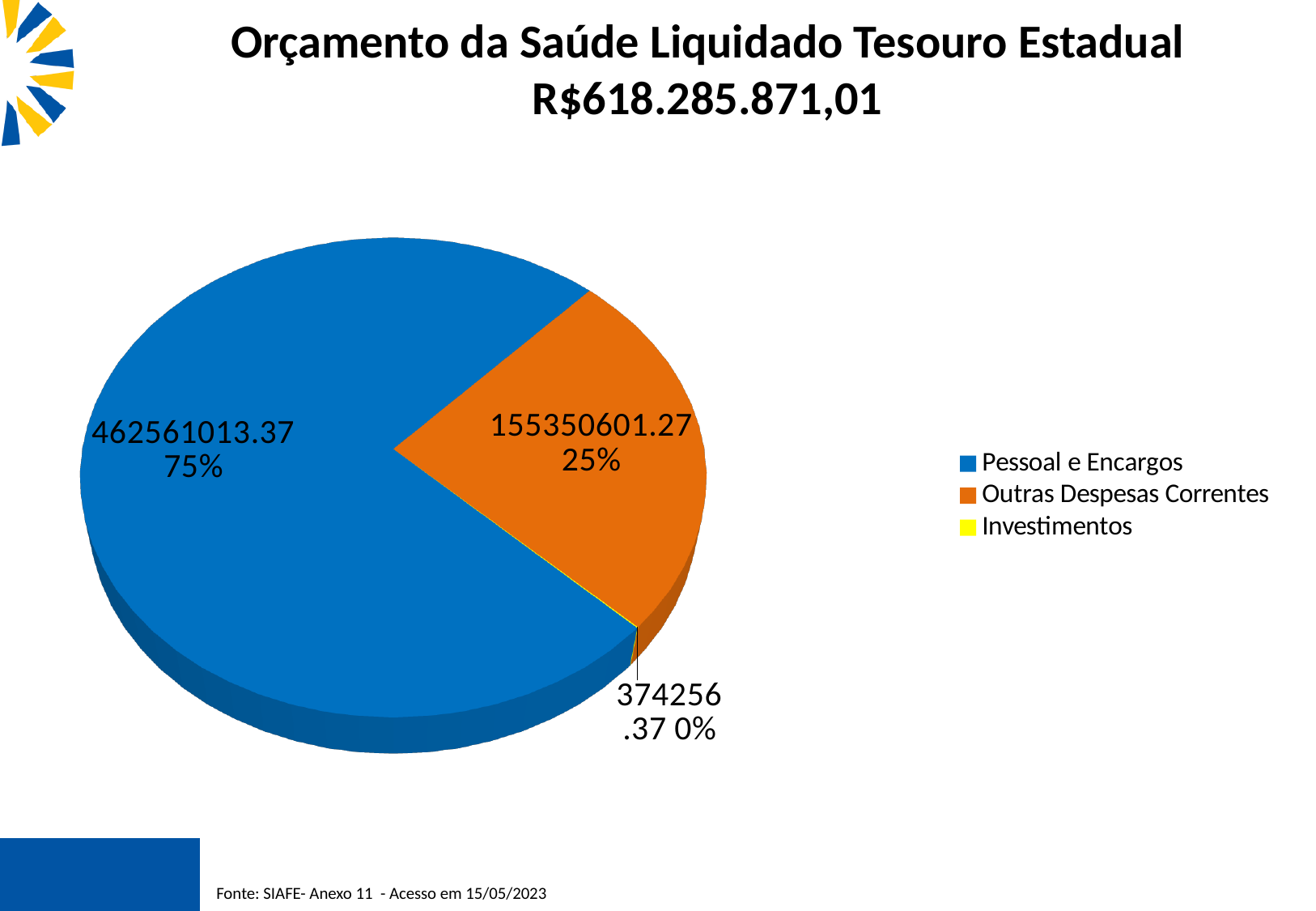
Which category has the largest slice? Pessoal e Encargos What share of the pie does Pessoal e Encargos represent? 75% What is the value for Investimentos? 374256.37 What kind of chart is shown on the slide? Pie chart What colour is the Outras Despesas Correntes slice? Orange How many categories does the legend list? 3 What share of the pie does Investimentos represent? 0% Which category has the smallest slice? Investimentos What is the value for Outras Despesas Correntes? 155350601.27 What is the value for Pessoal e Encargos? 462561013.37 What share of the pie does Outras Despesas Correntes represent? 25% Which is larger, Outras Despesas Correntes or Investimentos? Outras Despesas Correntes